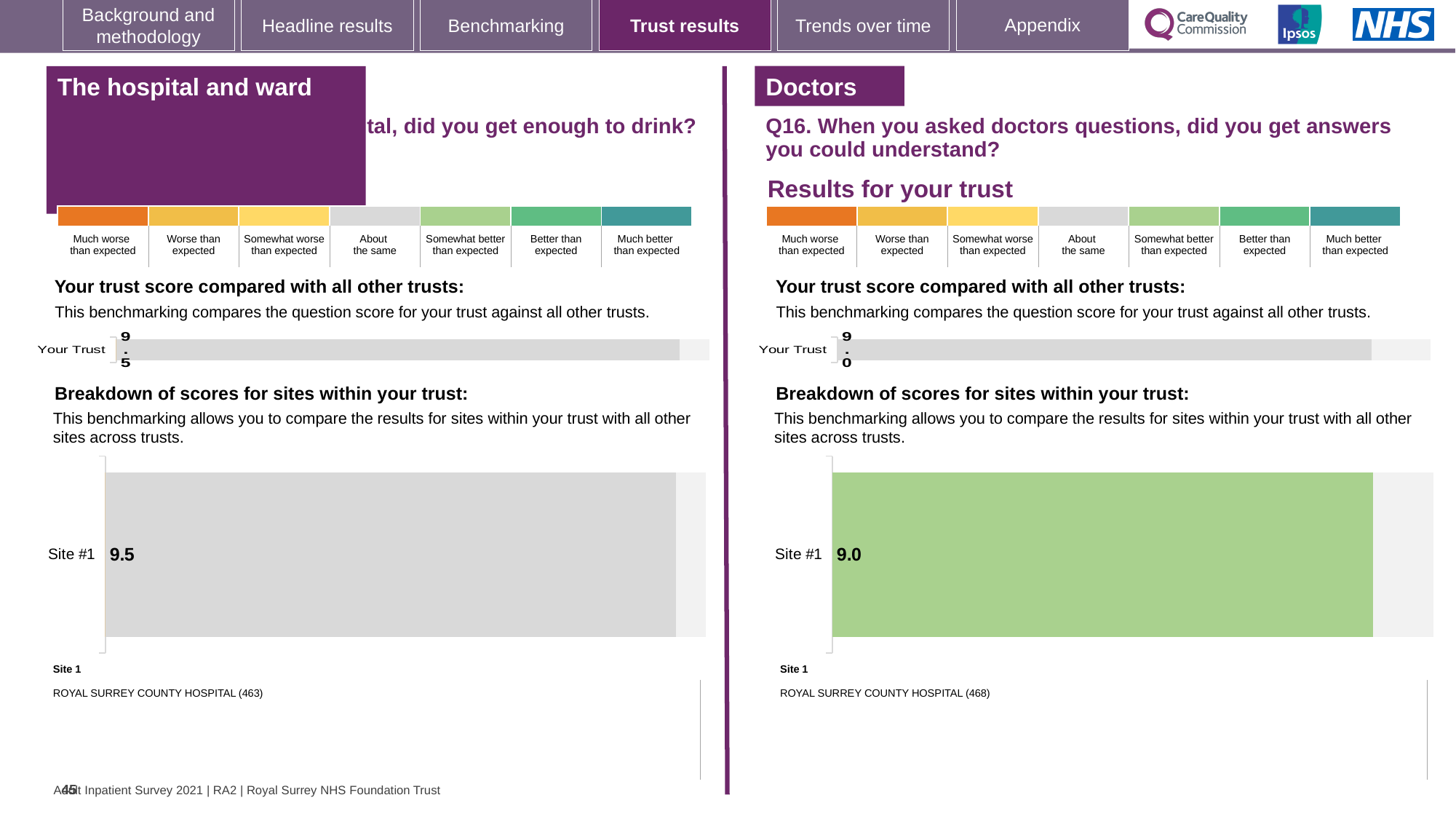
In the left panel (The hospital and ward), what is the score shown for Site #1? 9.5 In the right panel (Doctors, Q16), which benchmark category does the colour of the Site #1 bar correspond to? Somewhat better than expected How many sites are shown in the site breakdown chart of the left panel (The hospital and ward)? 1 In the left panel (The hospital and ward), which benchmark category does the colour of the Site #1 bar correspond to? About the same Which Site #1 score is larger: the one in the left panel (The hospital and ward) or the one in the right panel (Doctors, Q16)? Left panel (The hospital and ward) In the left panel (The hospital and ward), what is the 'Your Trust' score in the trust comparison chart? 9.5 Which site name is listed as Site 1 in the right panel (Doctors, Q16)? ROYAL SURREY COUNTY HOSPITAL (468) How many sites are shown in the site breakdown chart of the right panel (Doctors, Q16)? 1 In the right panel (Doctors, Q16), what is the score shown for Site #1? 9.0 What type of chart is used to show the Site #1 score in each panel? Bar chart What is the difference between the Site #1 score in the left panel (9.5) and the Site #1 score in the right panel (9.0)? 0.5 In the right panel (Doctors, Q16), what is the 'Your Trust' score in the trust comparison chart? 9.0